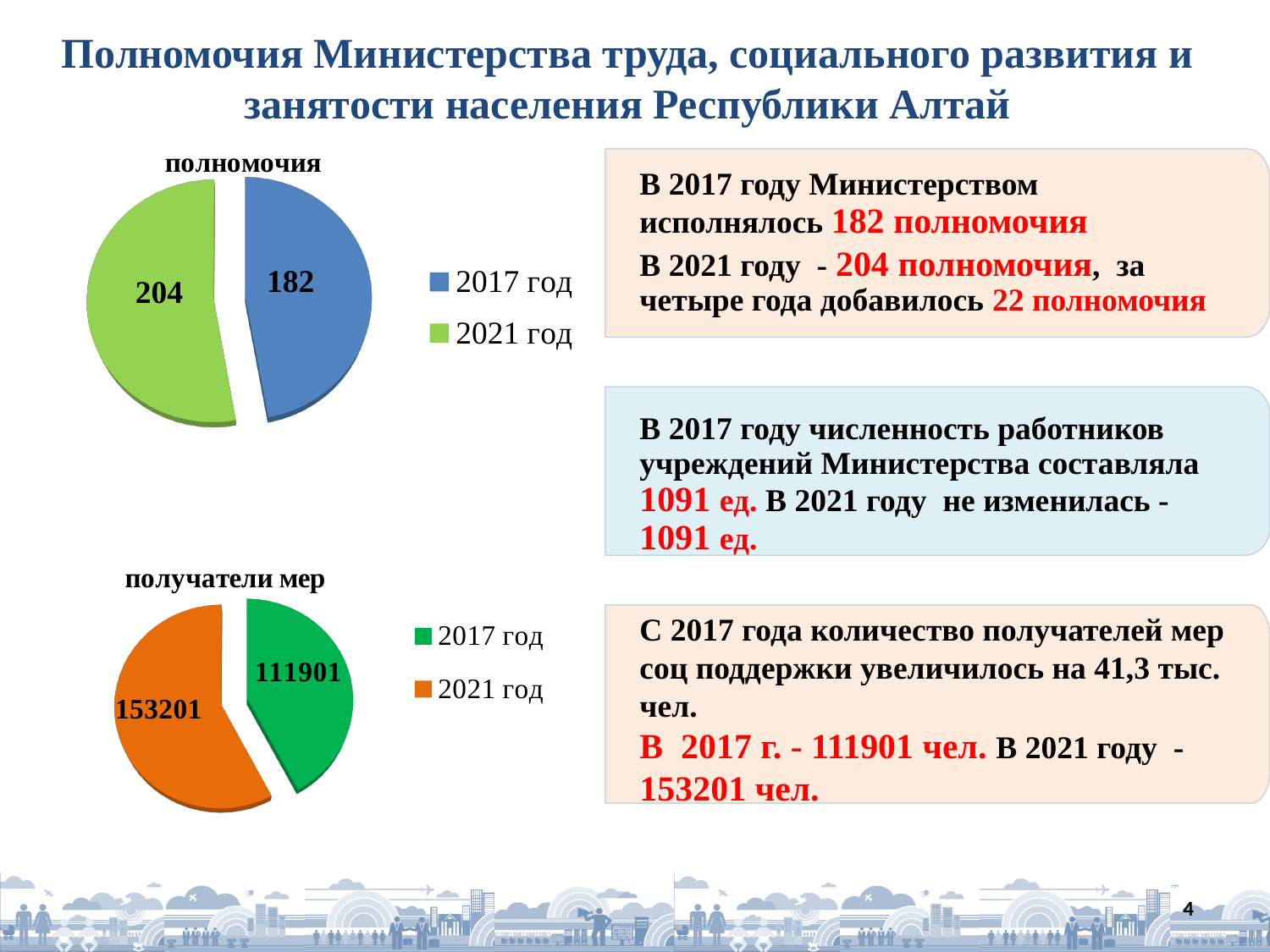
In the chart titled "получатели мер", which colour represents 2021 год? orange In the chart titled "получатели мер", what is the value for 2021 год? 153201 In the chart titled "получатели мер", what is the value for 2017 год? 111901 In the chart titled "полномочия", which year has the larger value? 2021 год What type of chart is the chart titled "полномочия"? pie chart In the chart titled "полномочия", what is the difference between the 2021 год and 2017 год values? 22 In the chart titled "получатели мер", which year has the smaller value? 2017 год In the chart titled "получатели мер", what is the difference between the 2021 год and 2017 год values? 41300 In the chart titled "полномочия", what is the value for 2021 год? 204 How many slices does the chart titled "получатели мер" have? 2 In the chart titled "получатели мер", is the value for 2021 год larger or smaller than the value for 2017 год? larger In the chart titled "полномочия", what is the value for 2017 год? 182